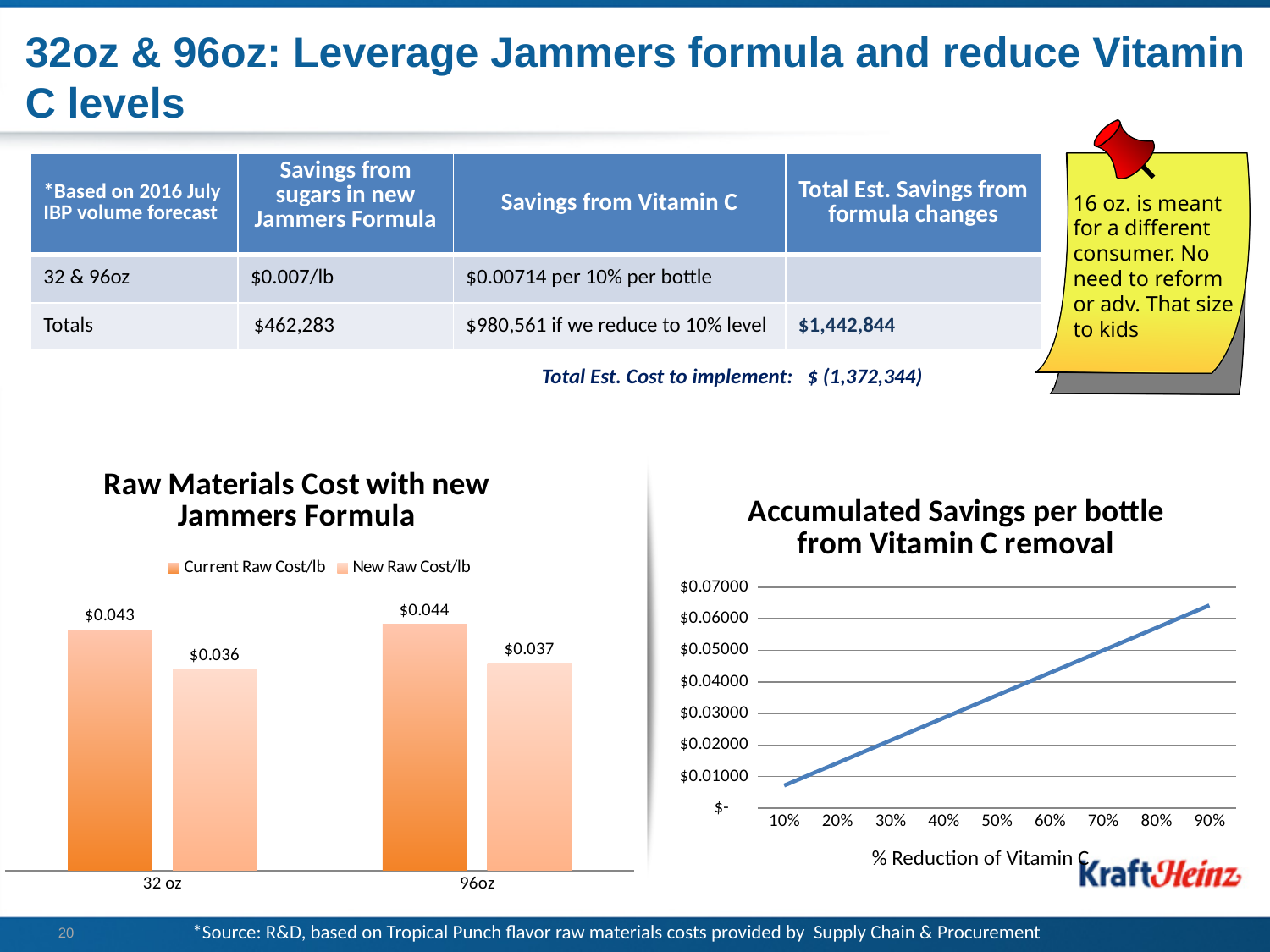
In the 'Accumulated Savings per bottle from Vitamin C removal' chart, do the values rise or fall as the % Reduction of Vitamin C increases? Rise In the 'Raw Materials Cost with new Jammers Formula' chart, what is the Current Raw Cost/lb for 32 oz? $0.043 In the 'Accumulated Savings per bottle from Vitamin C removal' chart, is the value at 90% greater or less than $0.06000? greater In the 'Raw Materials Cost with new Jammers Formula' chart, how many categories are shown on the x axis? 2 In the 'Raw Materials Cost with new Jammers Formula' chart, how many series does the legend list? 2 In the 'Raw Materials Cost with new Jammers Formula' chart, what is the New Raw Cost/lb for 96oz? $0.037 In the 'Accumulated Savings per bottle from Vitamin C removal' chart, what is the x-axis title? % Reduction of Vitamin C In the 'Raw Materials Cost with new Jammers Formula' chart, what is the difference between the Current Raw Cost/lb and the New Raw Cost/lb for 96oz? $0.007 What kind of chart is 'Accumulated Savings per bottle from Vitamin C removal'? Line chart In the 'Raw Materials Cost with new Jammers Formula' chart, what is the New Raw Cost/lb for 32 oz? $0.036 In the 'Raw Materials Cost with new Jammers Formula' chart, which is larger for 32 oz: the Current Raw Cost/lb or the New Raw Cost/lb? Current Raw Cost/lb What kind of chart is 'Raw Materials Cost with new Jammers Formula'? Bar chart